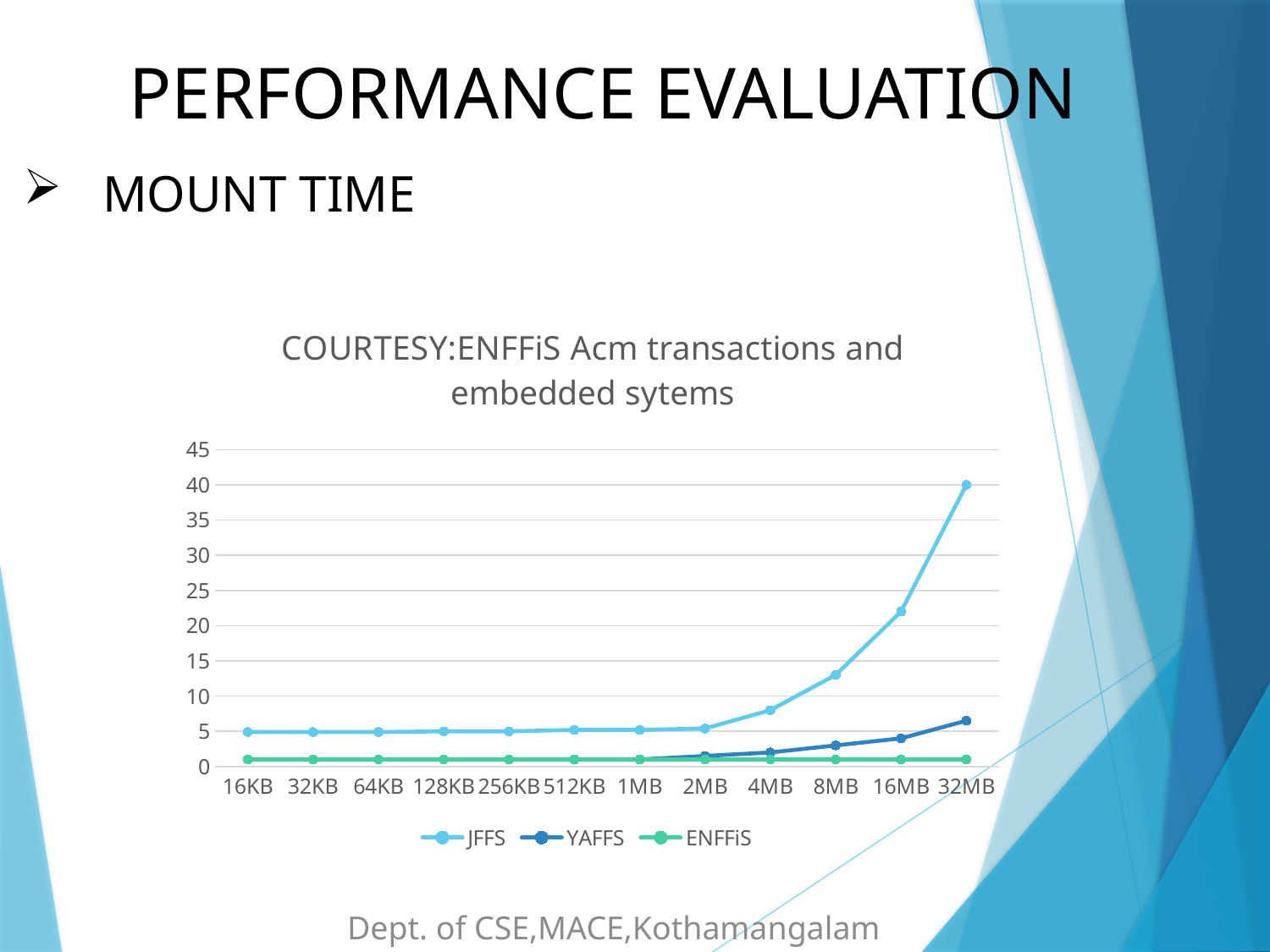
Do the JFFS values rise or fall as the x axis moves from 16KB to 32MB? rise Is the value for JFFS at 16MB greater or less than 20? greater What kind of chart is shown on the slide? line chart Is the value for YAFFS at 32MB greater or less than 10? less Which series has the highest value at 32MB? JFFS Which series has the lowest value at 32MB? ENFFiS What are the three series named in the legend? JFFS, YAFFS, ENFFiS Is the value for JFFS at 4MB greater or less than 10? less How many categories are shown along the x axis? 12 How many series does the legend list? 3 At 8MB, which series has the larger value, JFFS or YAFFS? JFFS